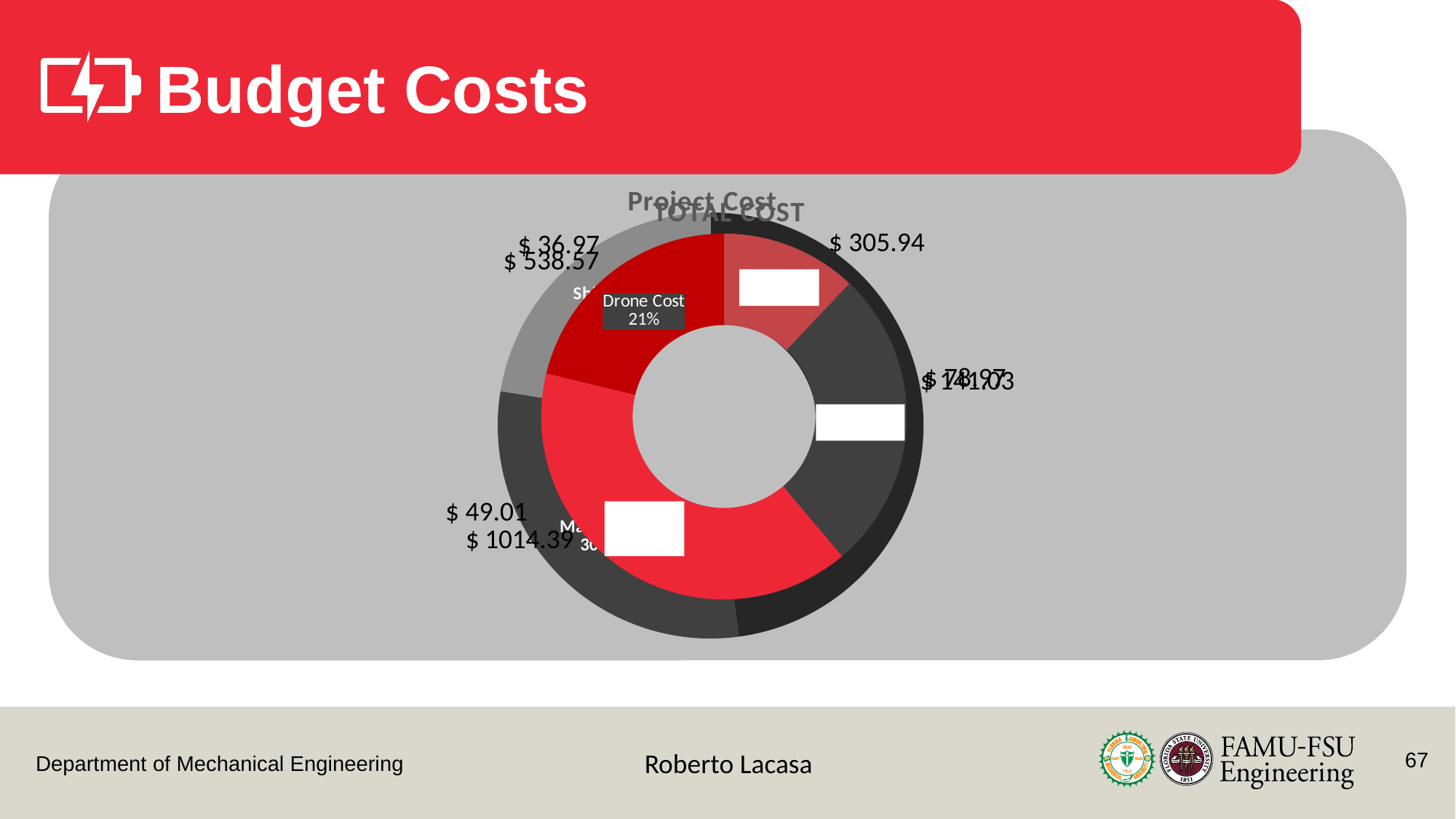
What colour is the slice labelled Drone Cost? Dark red What kind of chart is shown on the slide? Doughnut (pie) chart What is the largest dollar value printed as a data label on the chart? $ 1014.39 What is the smallest dollar value printed as a data label on the chart? $ 36.97 What share of the chart does the Drone Cost slice represent? 21% Which is larger among the printed data labels, $ 305.94 or $ 141.03? $ 305.94